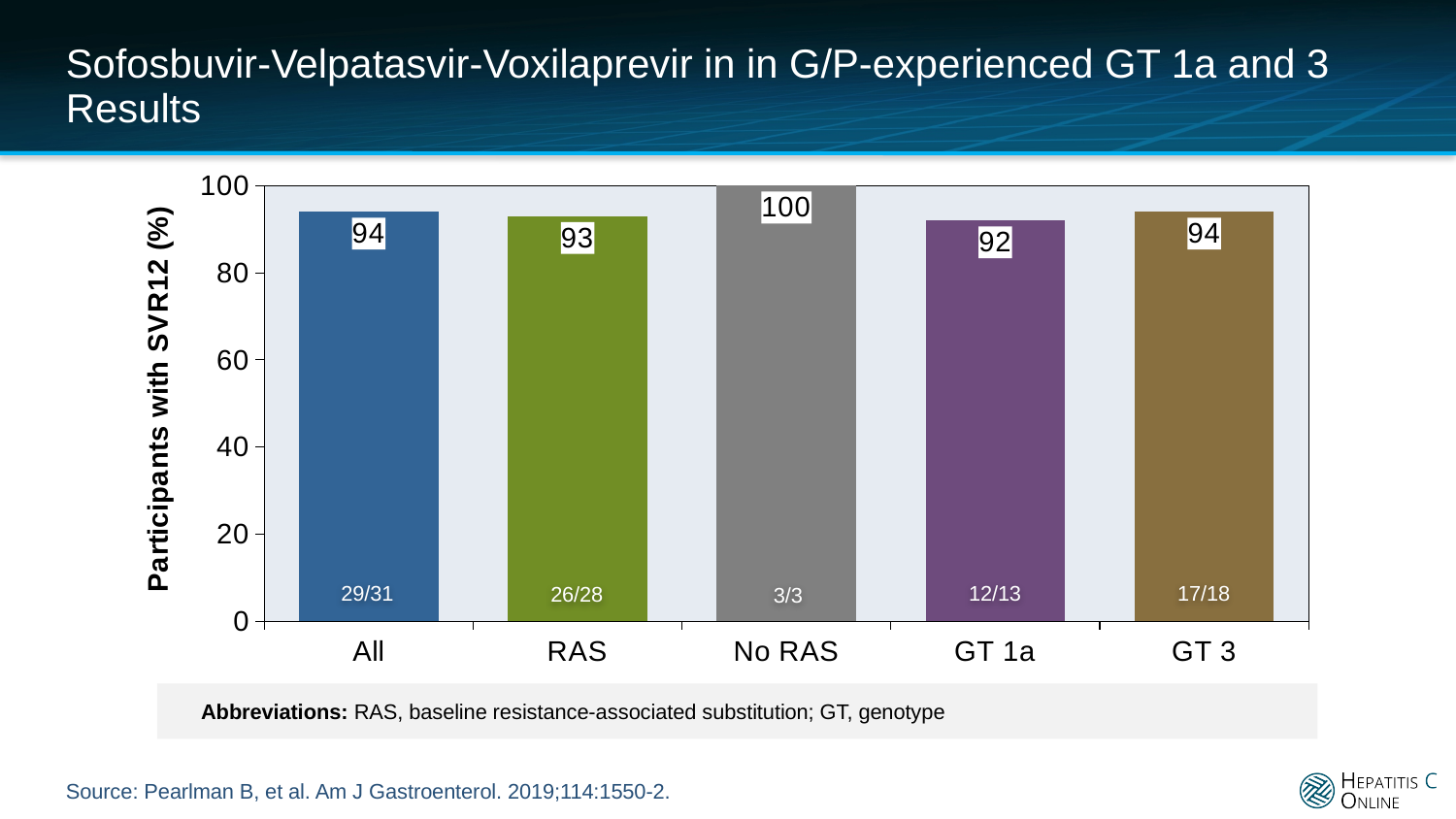
Which group has the highest SVR12 rate? No RAS What fraction of participants achieved SVR12 in the No RAS group? 3/3 Which group has a higher SVR12 rate, RAS or GT 3? GT 3 What is the SVR12 rate for the RAS group? 93 What is the difference in SVR12 rate between the No RAS group and the GT 1a group? 8 What fraction of participants achieved SVR12 in the GT 3 group? 17/18 What is the label of the y axis? Participants with SVR12 (%) Which group has the lowest SVR12 rate? GT 1a What is the SVR12 rate for the All group? 94 What is the SVR12 rate for the GT 1a group? 92 How many groups are shown on the x axis? 5 What kind of chart is shown on the slide? Bar chart